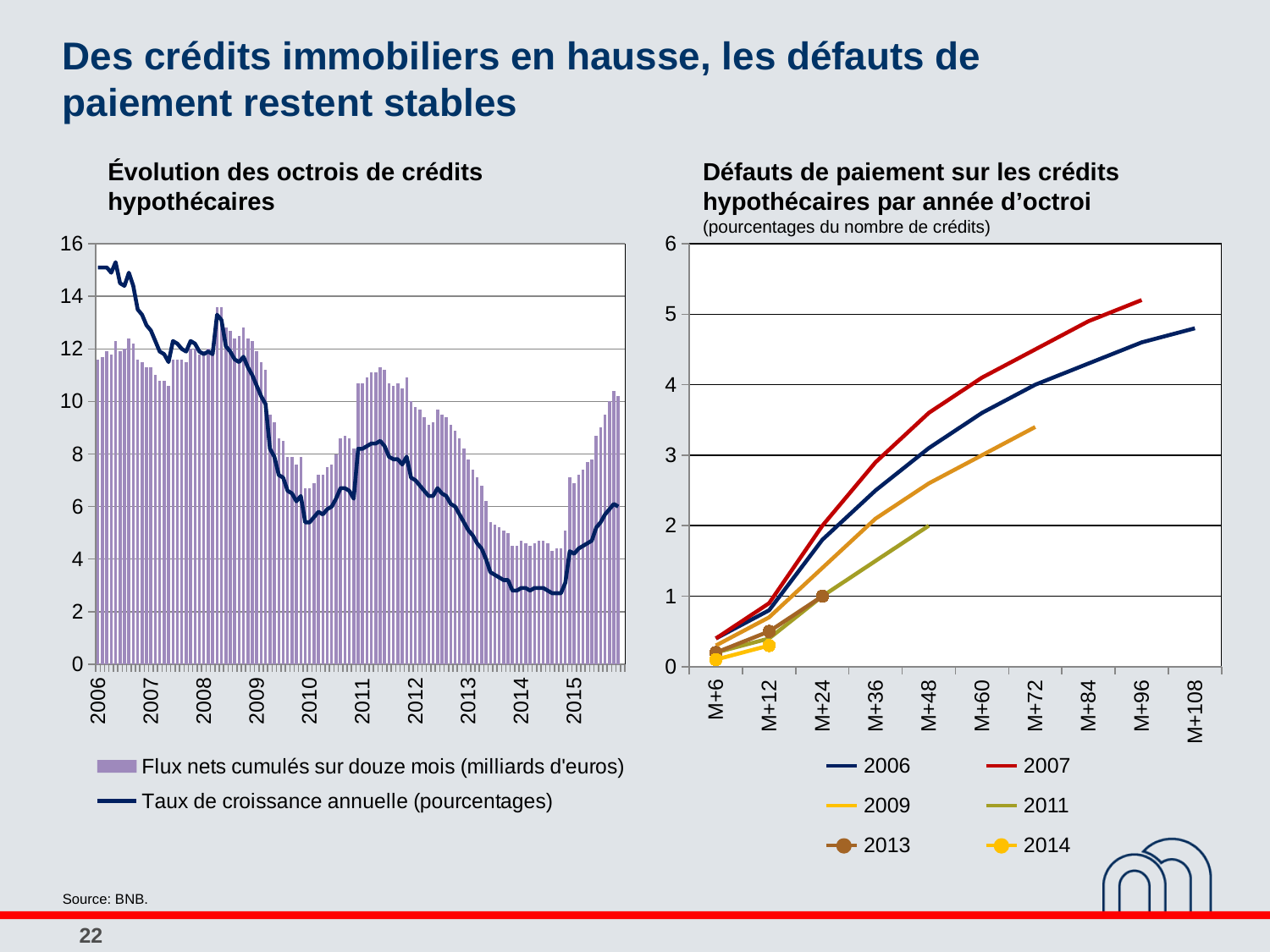
In the right chart, is the value of the 2007 series at M+96 greater or less than 4? greater In the right chart, do the values of the 2006 series rise or fall as the x axis moves from M+6 to M+108? Rise In the left chart, is the annual growth rate (Taux de croissance annuelle) at the start of 2006 greater or less than 14? greater How many series does the legend of the right chart list? 6 In the right chart, which series extends furthest along the x axis, to M+108? 2006 What type of chart is the left chart, 'Évolution des octrois de crédits hypothécaires'? A bar chart combined with a line In the right chart, at M+48, which series is higher: 2006 or 2009? 2006 In the left chart, does the annual growth rate line rise or fall between 2006 and 2010? Fall In the right chart, which series reaches the highest value at M+96? 2007 In the right chart, is the value of the 2009 series at M+72 greater or less than 3? greater How many series does the legend of the left chart list? 2 What type of chart is the right chart, 'Défauts de paiement sur les crédits hypothécaires par année d'octroi'? Line chart